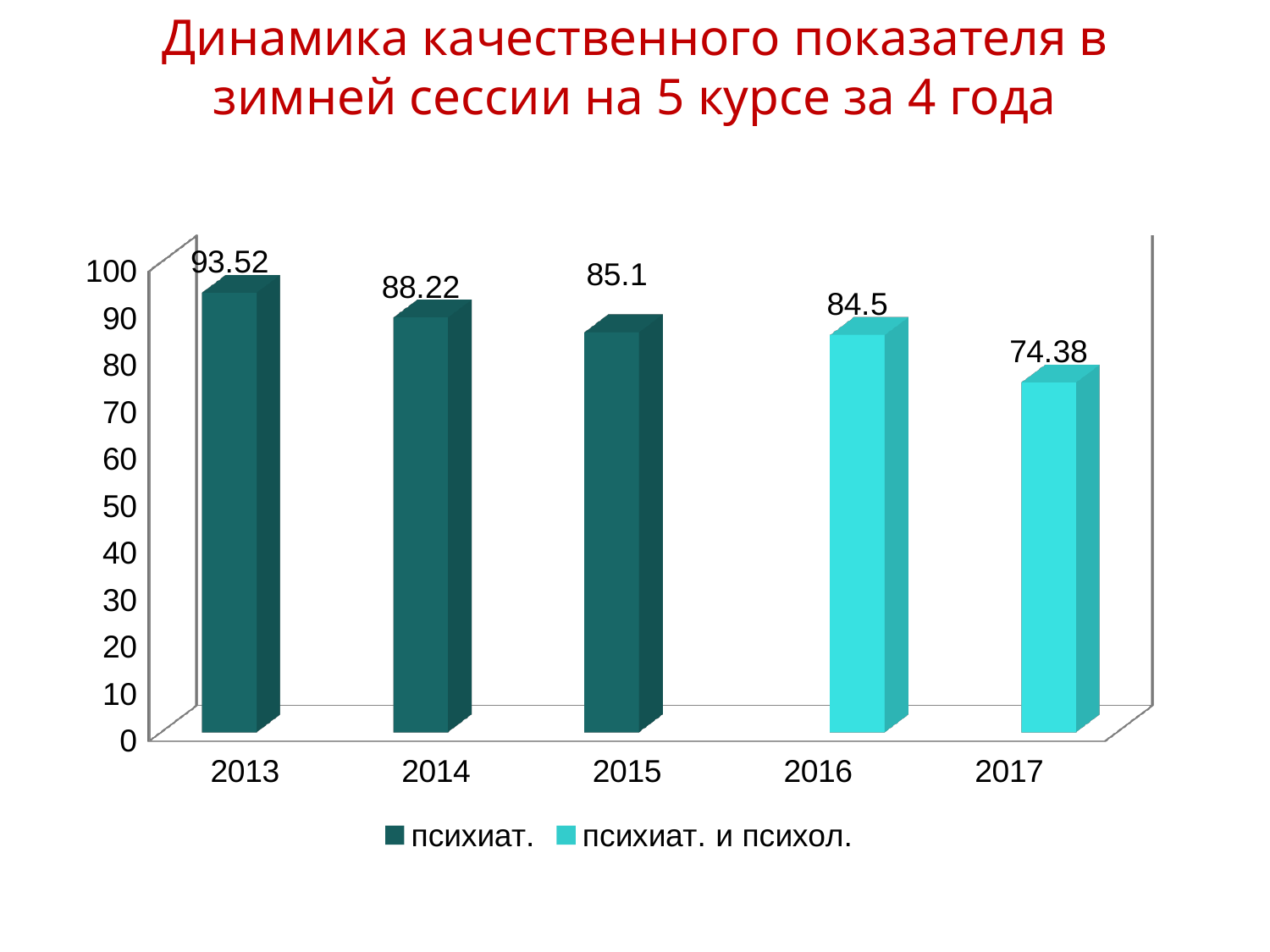
What is the difference between the values for 2016 and 2017? 10.12 Which is larger, the value for 2014 or the value for 2015? 2014 How many years are shown on the x axis? 5 What is the value for 2013? 93.52 What is the value for 2016? 84.5 What is the difference between the values for 2013 and 2014? 5.3 Is the value for 2017 greater or less than 80? less Do the values rise or fall from 2013 to 2017? fall What is the value for 2017? 74.38 Which year has the highest value? 2013 How many series does the legend list? 2 Which year has the lowest value? 2017